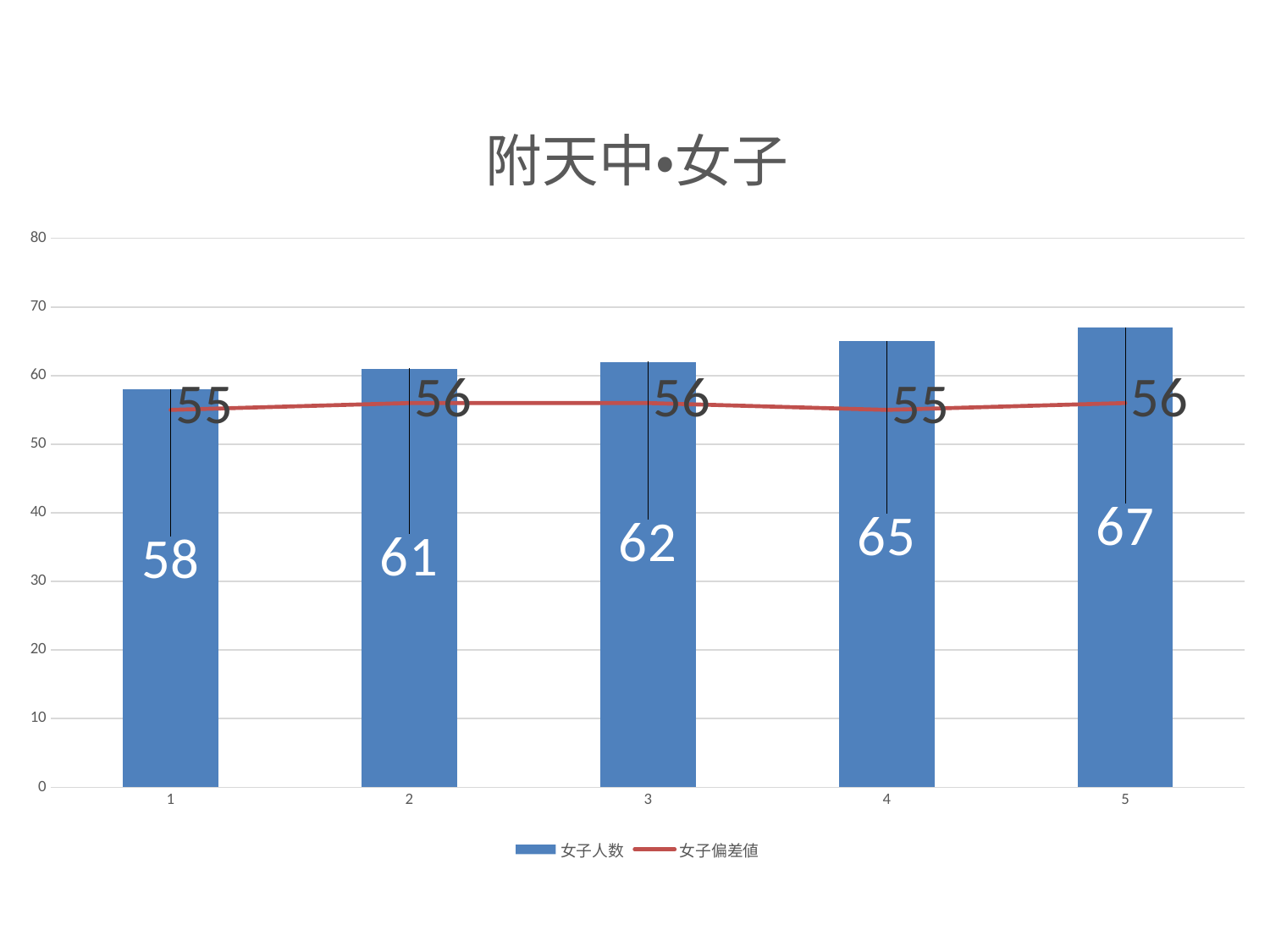
What is the value of 女子人数 for category 1? 58 What is the difference in 女子人数 between category 5 and category 1? 9 How many series does the legend list? 2 Which is larger, 女子人数 for category 2 or for category 4? category 4 Does 女子人数 rise or fall from category 1 to category 5? rise What is the value of 女子人数 for category 5? 67 What is the title of the chart? 附天中•女子 Which category has the lowest 女子人数? 1 How many categories are shown on the x axis? 5 What is the value of 女子偏差値 for category 4? 55 Which category has the highest 女子人数? 5 What is the value of 女子偏差値 for category 3? 56